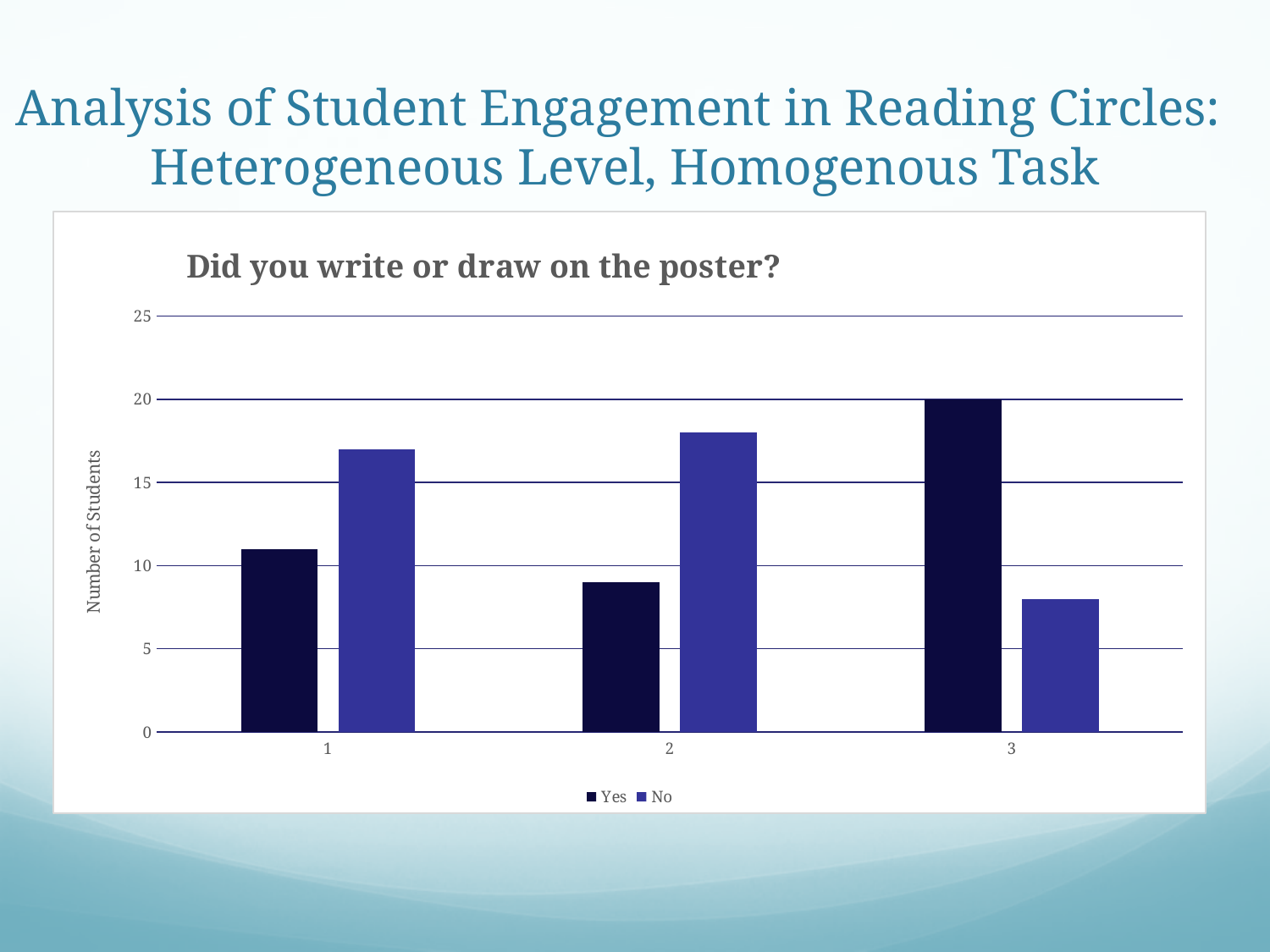
What is the Yes value for category 3? 20 How many series does the legend list? 2 What kind of chart is shown on the slide? bar chart For category 1, which is larger, the Yes value or the No value? No How many categories are shown on the x axis? 3 What is the title of the chart? Did you write or draw on the poster? Which category has the highest Yes value? 3 Is the No value for category 3 greater or less than 10? less What is the label on the vertical axis? Number of Students Which category has the lowest No value? 3 Is the No value for category 1 greater or less than 15? greater For category 3, which is larger, the Yes value or the No value? Yes